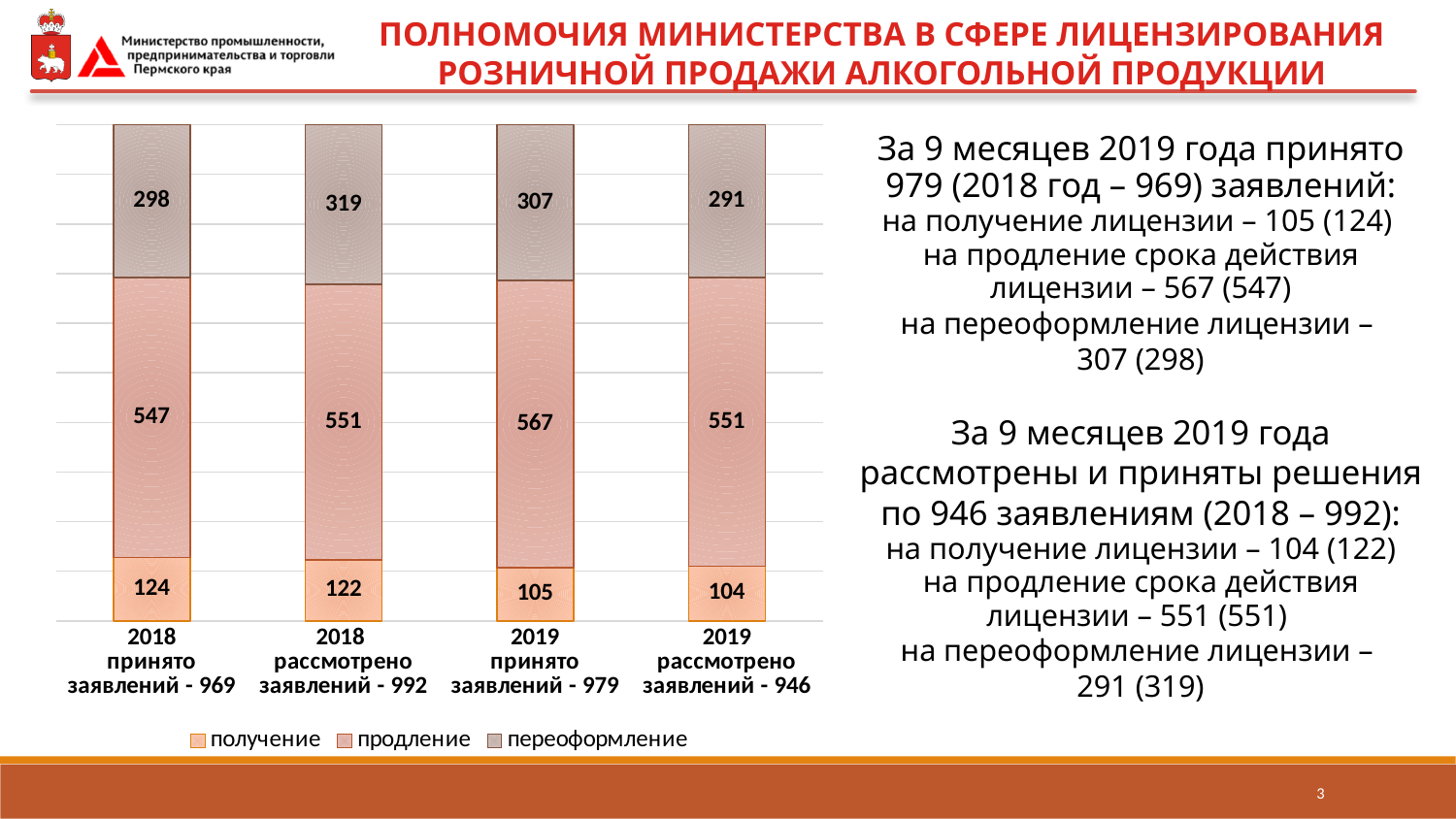
What kind of chart is shown on the slide? Stacked bar chart What is the total of the stacked bar for "2018 рассмотрено заявлений - 992"? 992 Which category has the highest "получение" value? 2018 принято заявлений - 969 Which is larger: the "переоформление" value for "2018 принято заявлений - 969" or for "2019 принято заявлений - 979"? 2019 принято заявлений - 979 What is the value of the "переоформление" segment for "2018 рассмотрено заявлений - 992"? 319 Which category has the lowest "переоформление" value? 2019 рассмотрено заявлений - 946 What is the value of the "получение" segment for "2019 рассмотрено заявлений - 946"? 104 What is the difference between the "продление" values for "2019 принято заявлений - 979" and "2018 принято заявлений - 969"? 20 Which series is shown at the top of each stacked bar? переоформление How many categories are shown on the x axis of the chart? 4 How many series does the chart legend list? 3 What is the value of the "продление" segment for "2019 принято заявлений - 979"? 567